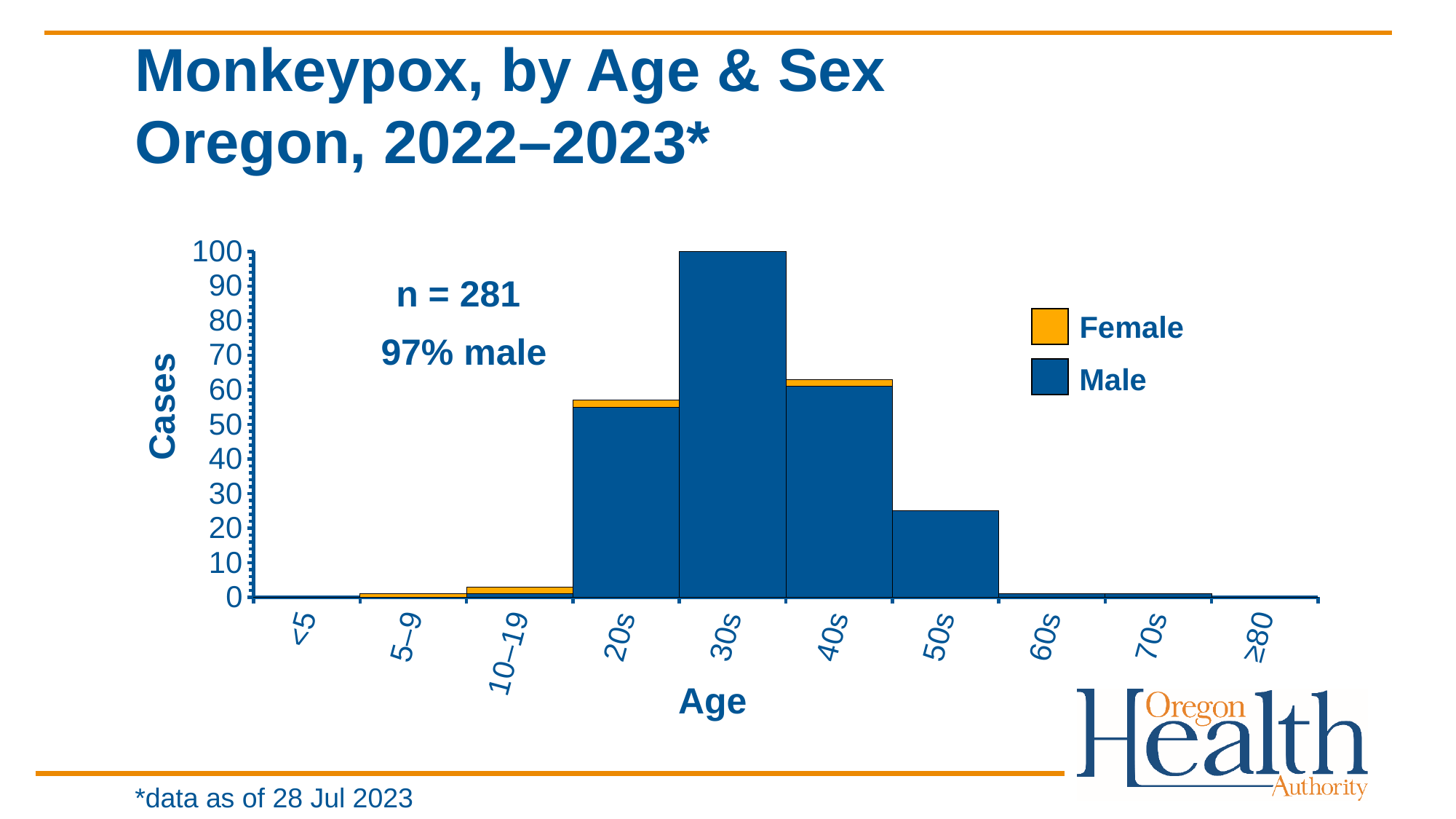
Is the total number of cases for the 30s age group greater or less than 90? greater Which age group has the highest number of cases? 30s What kind of chart is shown on the slide? Stacked bar chart How many age categories are shown on the x axis? 10 Which age group has more cases, 20s or 30s? 30s Is the total number of cases for the 20s age group greater or less than 50? greater Is the total number of cases for the 50s age group greater or less than 20? greater Which colour represents Female cases in the legend? Orange How many series does the legend list? 2 What total number of cases (n) is stated on the chart? n = 281 Which age group has more cases, 40s or 50s? 40s